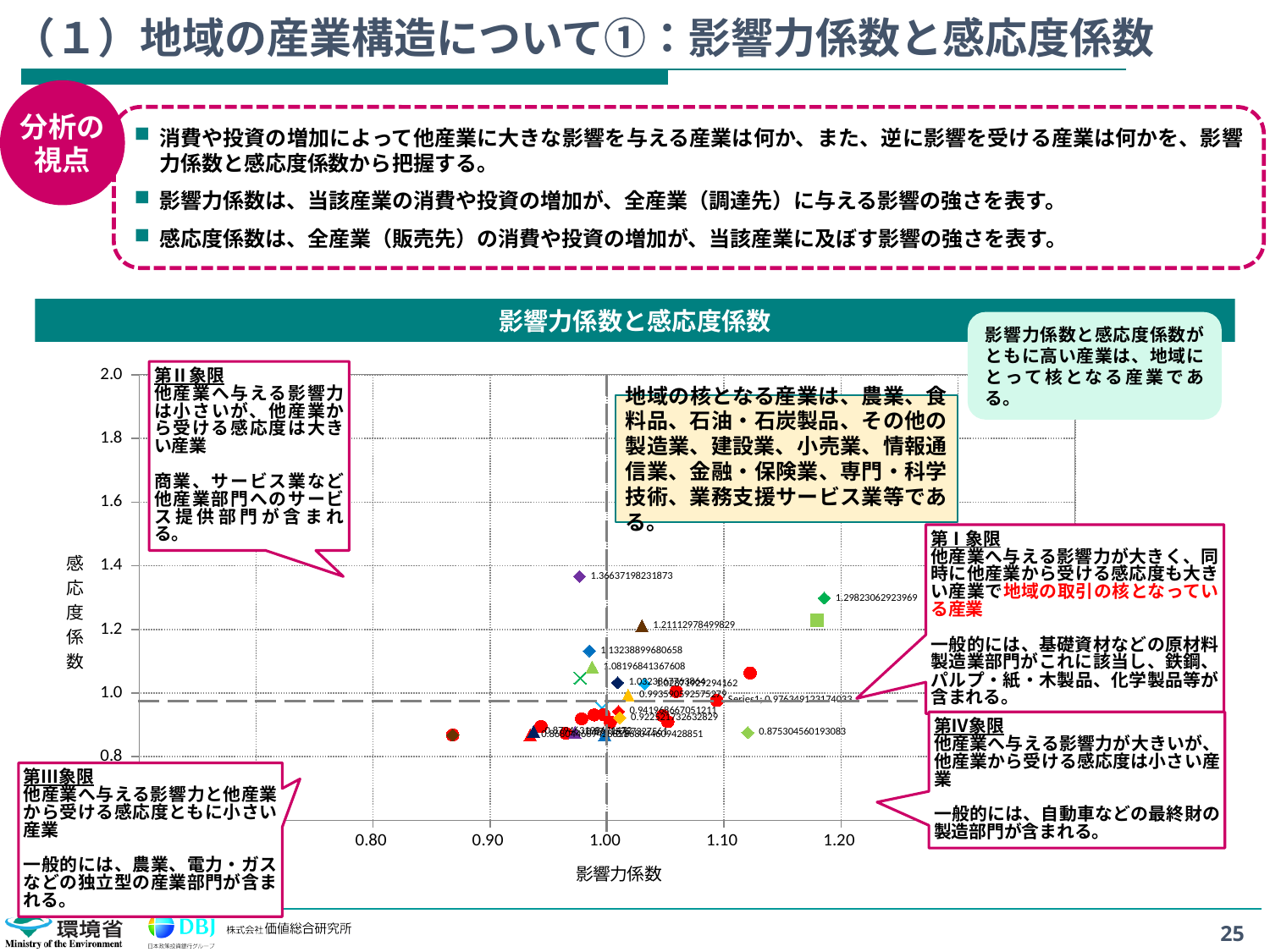
Which has the higher 感応度係数: the point labelled 1.13238899680658 or the point labelled 0.875304560193083? 1.13238899680658 What is the 感応度係数 value labelled on the brown triangle point near 影響力係数 1.03? 1.21112978499829 What is the title of the chart on the slide? 影響力係数と感応度係数 What is the 感応度係数 value labelled on the green diamond point near 影響力係数 1.18? 1.29823062923969 What is the difference between the labelled values 1.36637198231873 and 1.29823062923969? 0.06814135307904 Which has the higher 感応度係数: the point labelled 1.29823062923969 or the point labelled 1.21112978499829? 1.29823062923969 Is the 感応度係数 of the point labelled 0.875304560193083 greater or less than 1.0? less What kind of chart is shown on the slide? scatter chart What is the label of the horizontal axis of the chart? 影響力係数 What is the highest 感応度係数 value labelled on the chart? 1.36637198231873 Is the 影響力係数 of the point labelled 1.29823062923969 greater or less than 1.10? greater Is the 影響力係数 of the point labelled 1.36637198231873 greater or less than 1.00? less